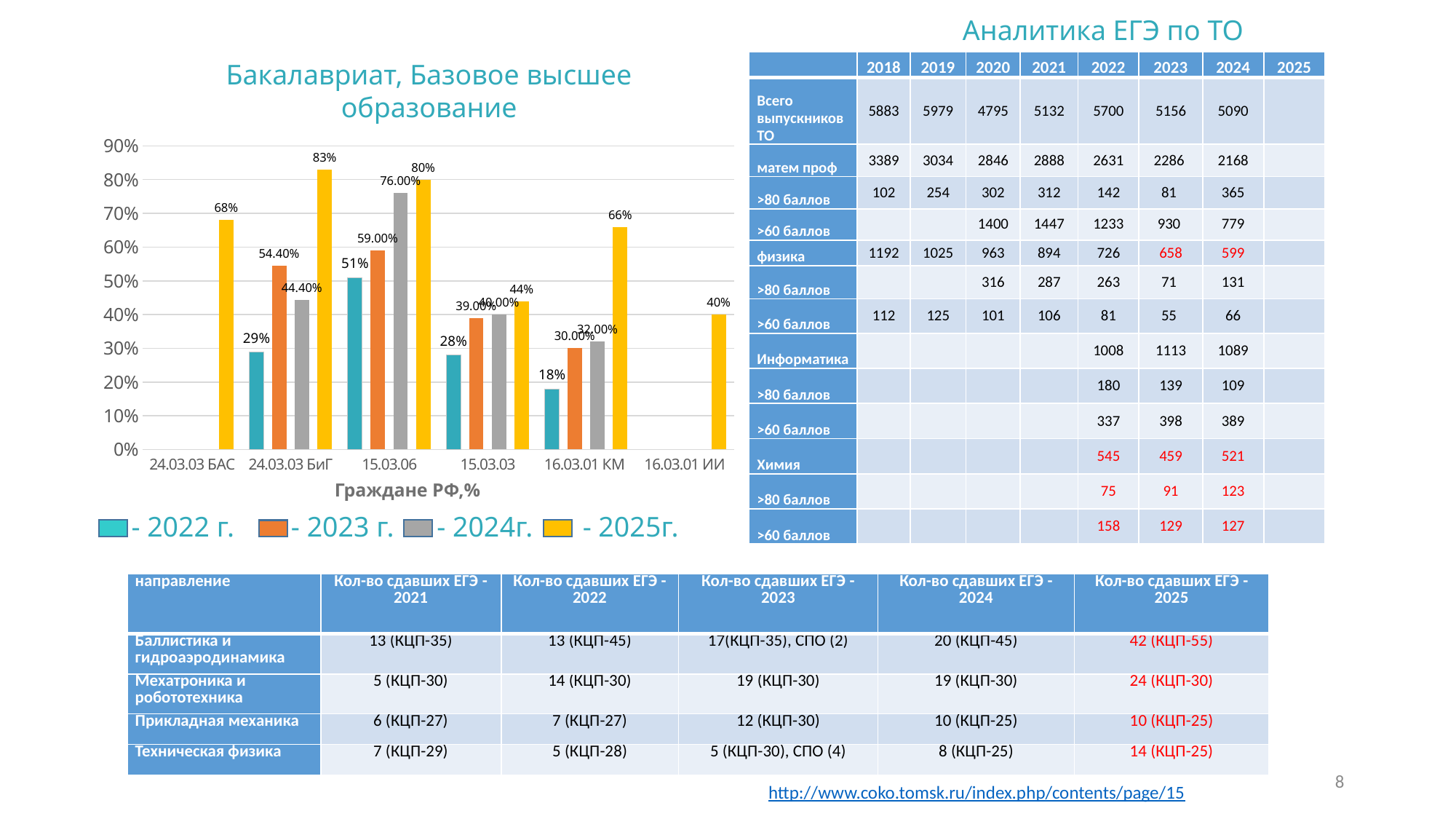
Do the values for 15.03.03 rise or fall from the 2022 series to the 2025 series? rise What is the value for 24.03.03 БиГ in the 2025 series? 83% What is the value for 15.03.06 in the 2024 series? 76.00% How many categories are shown on the x axis of the chart? 6 What is the title of the chart? Бакалавриат, Базовое высшее образование What is the value for 16.03.01 КМ in the 2022 series? 18% How many series does the chart legend list? 4 Which is larger: the 2023 value for 24.03.03 БиГ or the 2023 value for 15.03.06? 15.03.06 What is the difference between the 2025 and 2022 values for 15.03.06? 29% Which category has the highest value in the 2025 series? 24.03.03 БиГ Which category has the lowest value in the 2022 series? 16.03.01 КМ What type of chart is shown on the slide? bar chart